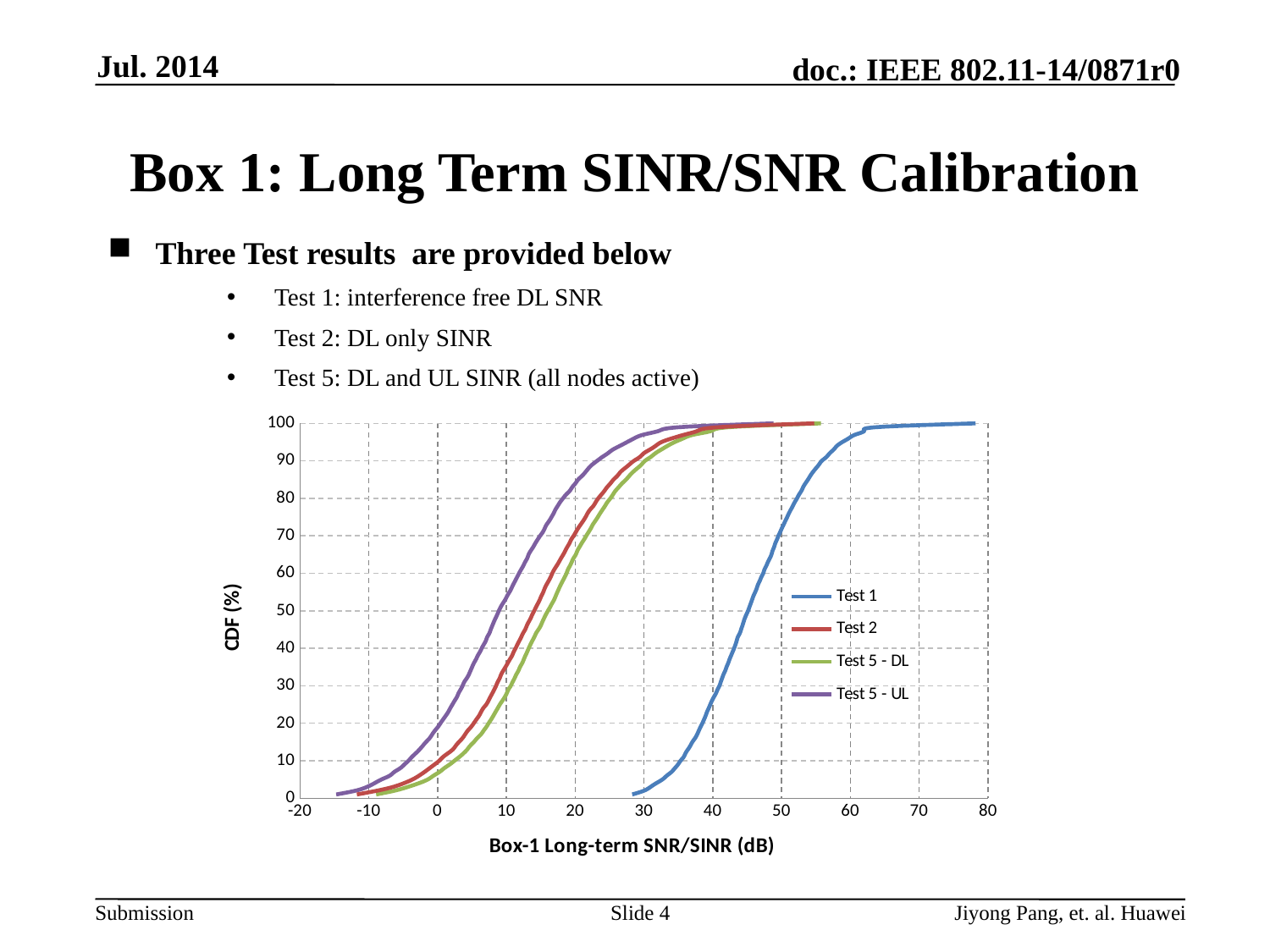
Is the CDF value for Test 5 - DL at 0 dB greater or less than 10? less How many series does the legend of the chart list? 4 Is the CDF value for Test 1 at 40 dB greater or less than 50? less What is the title of the y axis of the chart? CDF (%) At 10 dB, which series has the higher CDF value, Test 5 - UL or Test 2? Test 5 - UL What kind of chart is shown on the slide? line chart Do the CDF values of the Test 1 curve rise or fall as the SNR/SINR increases along the x axis? rise Is the CDF value for Test 1 at 50 dB greater or less than 50? greater Which series reaches 100% CDF at the highest SNR/SINR value? Test 1 Which series begins at the lowest SNR/SINR value on the x axis? Test 5 - UL What is the title of the x axis of the chart? Box-1 Long-term SNR/SINR (dB)